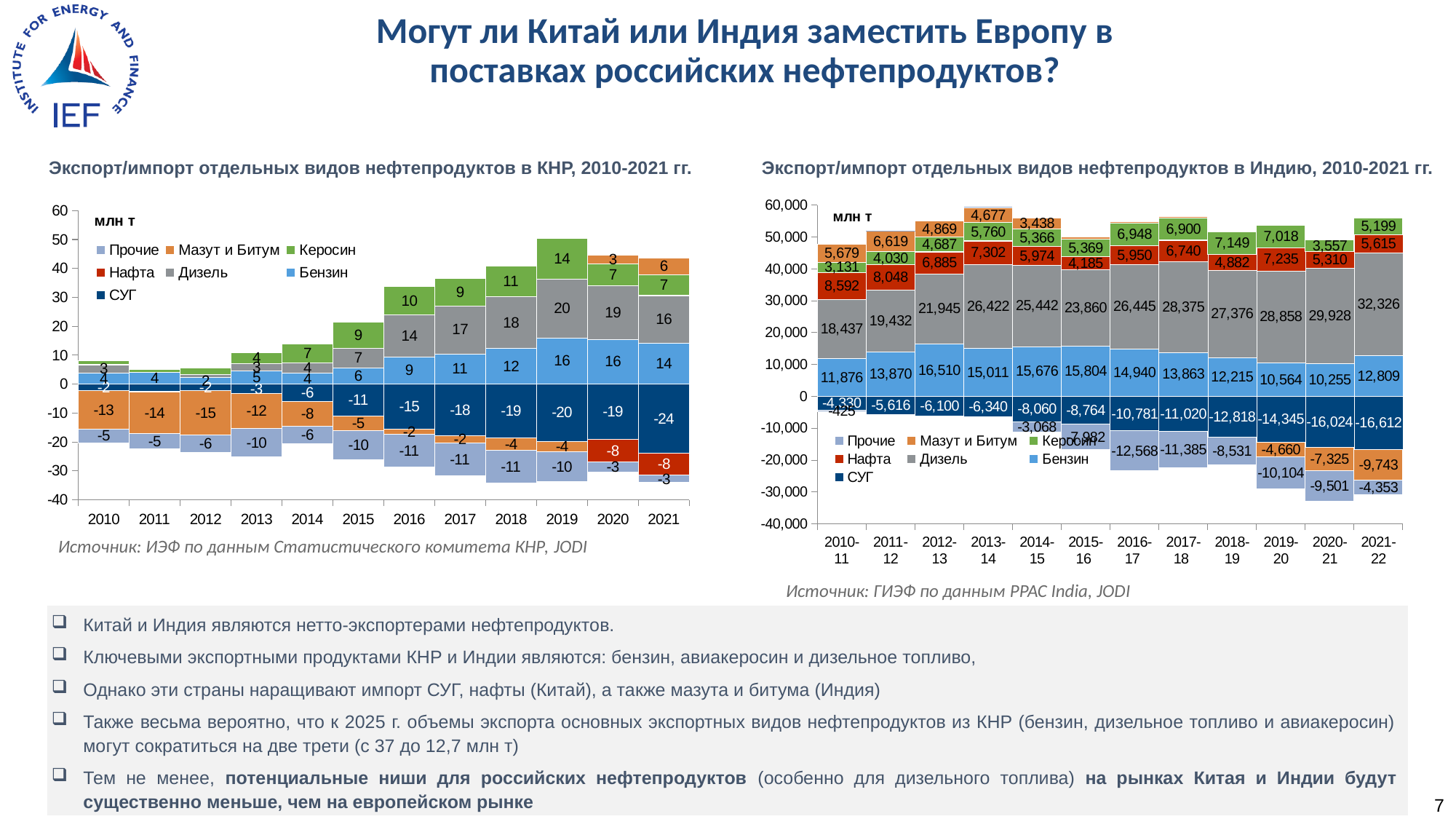
In the right chart (Индия), what is the value for Нафта in 2010-11? 8,592 In the left chart (КНР), in which year is the Дизель value highest? 2019 How many series does the legend of the right chart (Индия) list? 7 In the left chart (КНР), what is the value for Керосин in 2019? 14 In the left chart (КНР), what is the value for СУГ in 2021? -24 In the right chart (Индия), what is the value for СУГ in 2021-22? -16,612 In the left chart (КНР), what is the difference between the Керосин value in 2019 and in 2021? 7 What kind of chart is the left chart (КНР)? Stacked bar chart In the left chart (Экспорт/импорт отдельных видов нефтепродуктов в КНР), what is the value for Дизель in 2021? 16 In the right chart (Экспорт/импорт отдельных видов нефтепродуктов в Индию), what is the value for Дизель in 2021-22? 32,326 In the right chart (Индия), what is the difference between the Дизель value in 2021-22 and in 2010-11? 13,889 In the left chart (КНР), which is larger: the Бензин value in 2018 or in 2021? 2021